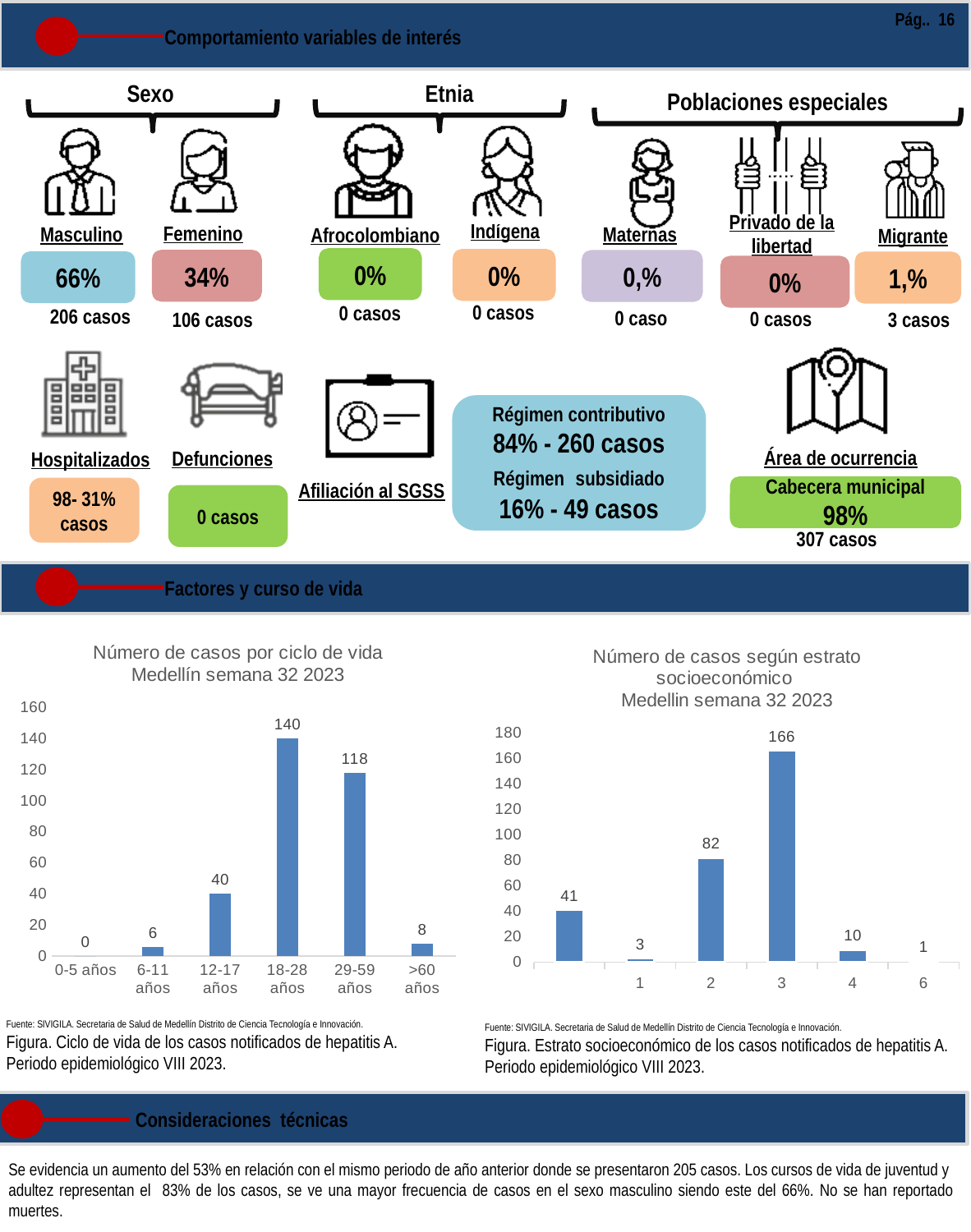
In the chart 'Número de casos por ciclo de vida', which has more cases: 12-17 años or >60 años? 12-17 años In the chart 'Número de casos por ciclo de vida', which age group has the highest number of cases? 18-28 años In the chart 'Número de casos según estrato socioeconómico', how many cases are shown for estrato 2? 82 In the chart 'Número de casos según estrato socioeconómico', which estrato has the highest number of cases? 3 In the chart 'Número de casos por ciclo de vida', how many cases are shown for the 29-59 años group? 118 In the chart 'Número de casos por ciclo de vida', how many age groups are shown on the x axis? 6 In the chart 'Número de casos por ciclo de vida', which age group has the lowest number of cases? 0-5 años In the chart 'Número de casos según estrato socioeconómico', what is the difference in cases between estrato 3 and estrato 2? 84 In the chart 'Número de casos por ciclo de vida', what is the difference in cases between the 18-28 años and 29-59 años groups? 22 What type of chart is 'Número de casos según estrato socioeconómico'? Bar chart In the chart 'Número de casos por ciclo de vida', how many cases are shown for the 18-28 años group? 140 In the chart 'Número de casos según estrato socioeconómico', how many cases are shown for estrato 3? 166